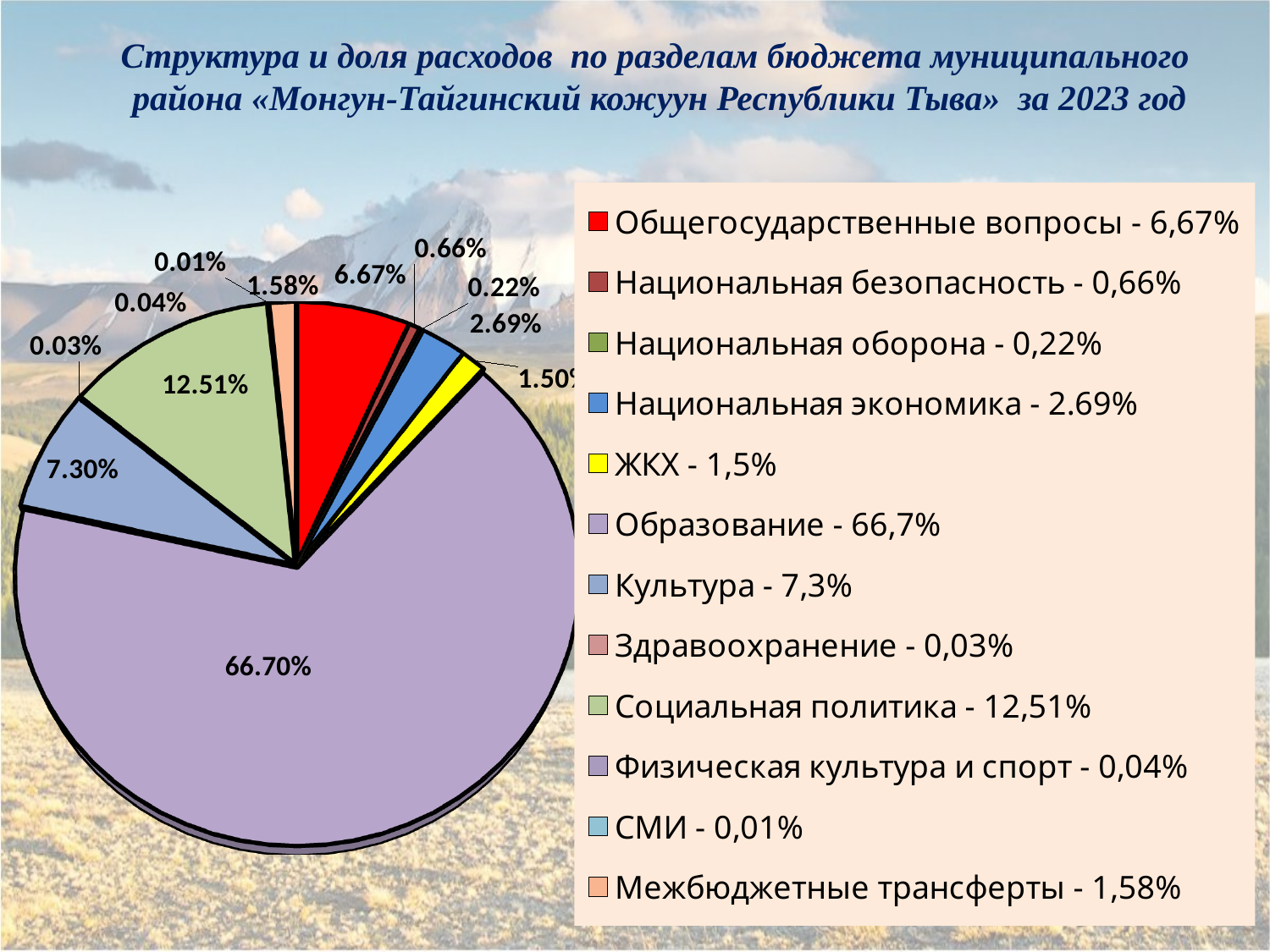
What colour is the slice for Общегосударственные вопросы? Red Which is larger: the share for Общегосударственные вопросы or the share for Культура? Культура How many categories (slices) does the pie chart have? 12 What kind of chart is shown on the slide? Pie chart What share of expenditures does Национальная экономика account for? 2.69% What is the difference in percentage points between the shares of Общегосударственные вопросы and Национальная безопасность? 6.01% What share of expenditures does Культура account for? 7.30% What share of expenditures does Социальная политика account for? 12.51% Which budget section has the smallest share of expenditures in the pie chart? СМИ What share of the pie does Образование take? 66.70% Which budget section has the largest share of expenditures in the pie chart? Образование What is the difference in percentage points between the shares of Образование and Социальная политика? 54.19%